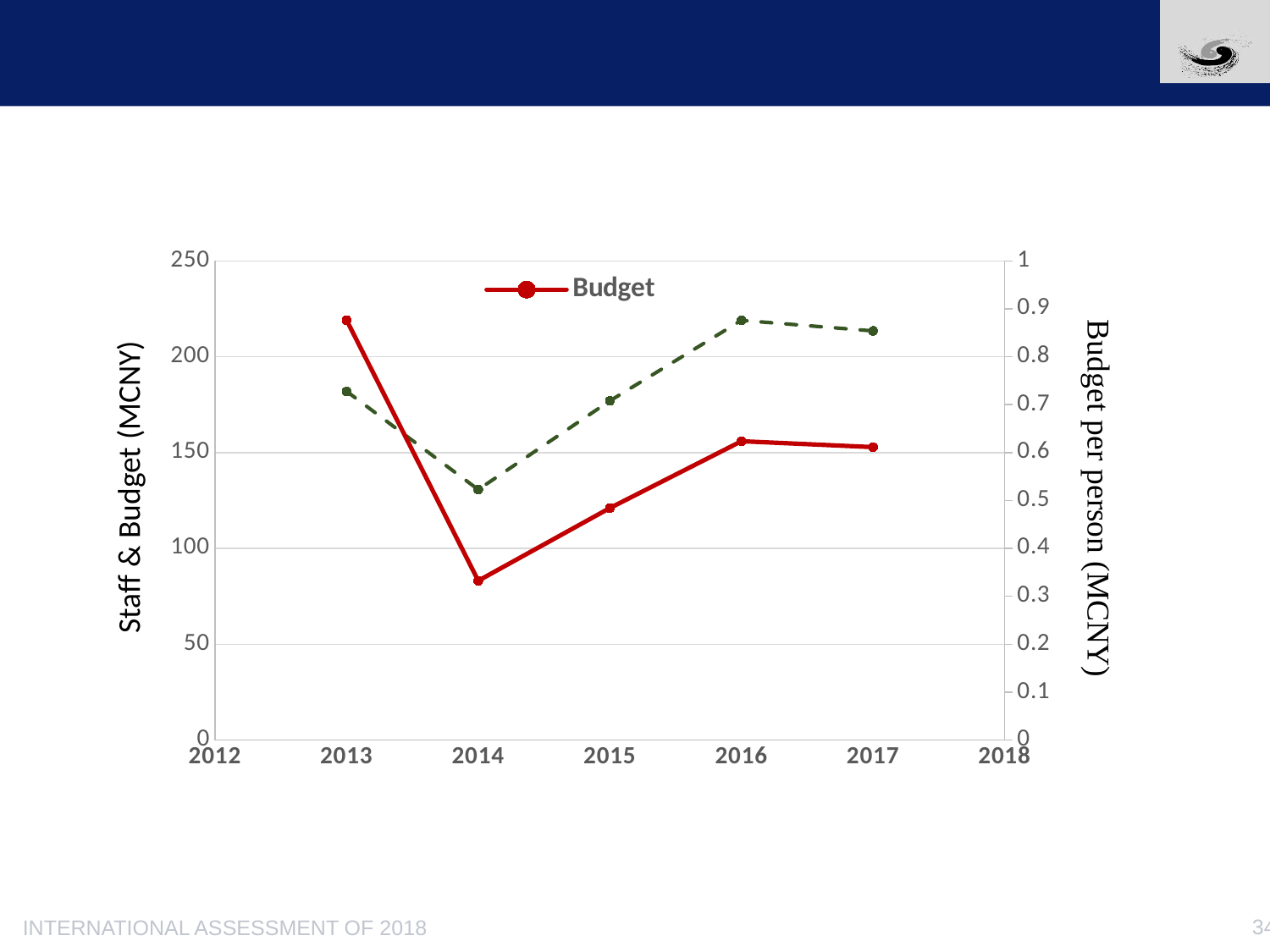
How many data points does the Budget line have? 5 What kind of chart is shown on the slide? line chart In which year is the Budget line at its highest? 2013 Which series is named in the chart's legend? Budget Is the Budget value for 2013 greater or less than 200 on the left axis? greater Which is larger, the Budget value for 2013 or for 2016? 2013 Does the Budget line rise or fall from 2013 to 2014? fall In which year is the Budget line at its lowest? 2014 How many series does the chart's legend list? 1 Is the Budget value for 2017 greater or less than 200 on the left axis? less Is the Budget value for 2014 greater or less than 100 on the left axis? less What is the title of the left vertical axis? Staff & Budget (MCNY)